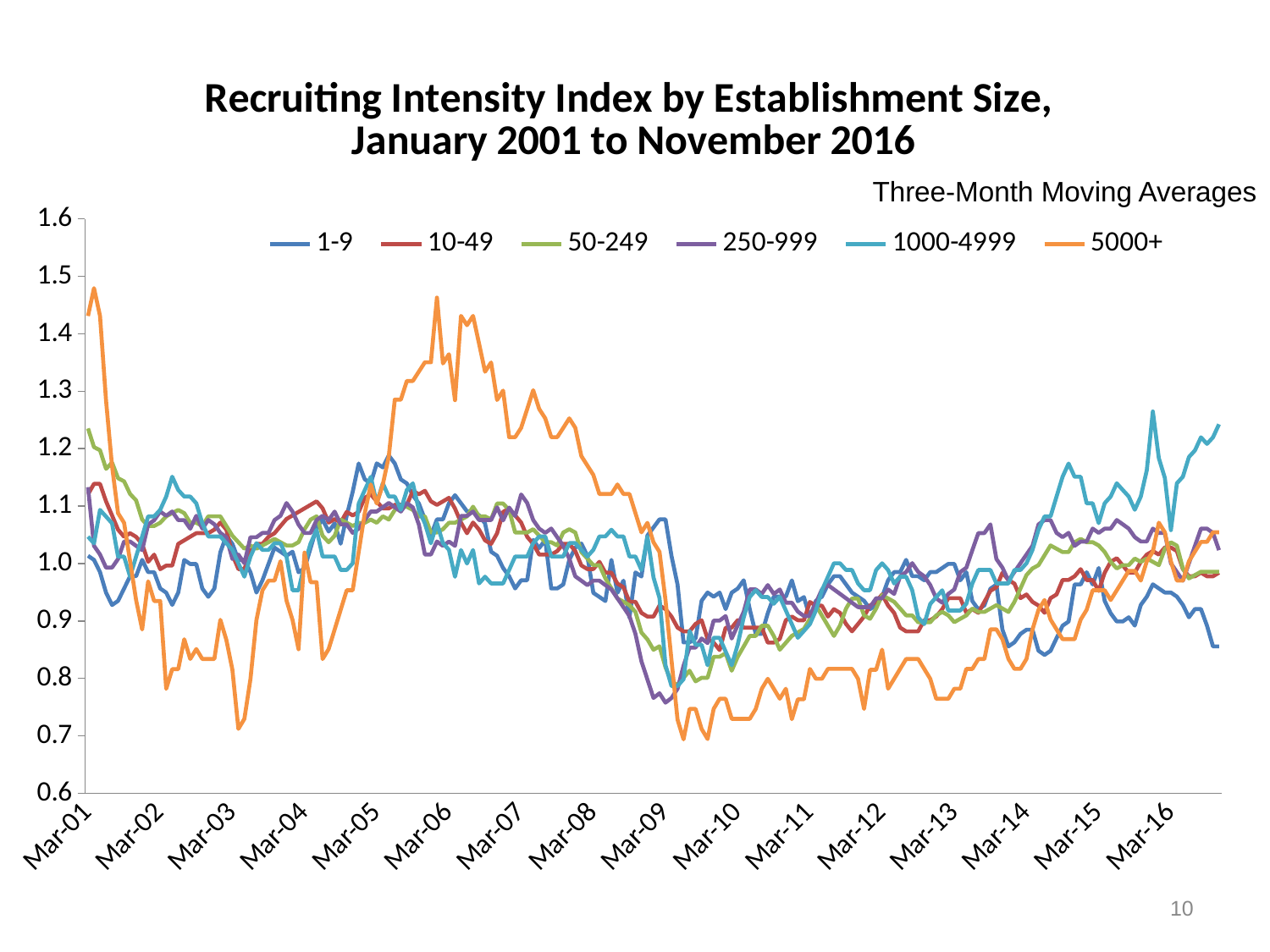
Which series has the lowest value around Mar-10? 5000+ Around Mar-03, which is larger: the 1-9 series or the 5000+ series? 1-9 Is the value for the 5000+ series around Mar-06 greater or less than 1.3? greater What does the note above the legend say the plotted values are? Three-Month Moving Averages Is the value for the 5000+ series around Mar-10 greater or less than 0.8? less How many series does the legend list? 6 What is the title of the chart? Recruiting Intensity Index by Establishment Size, January 2001 to November 2016 Which series has the lowest value at the end of the period, after Mar-16? 1-9 Which series has the highest value at the end of the period, after Mar-16? 1000-4999 What kind of chart is shown on the slide? line chart Does the 5000+ series rise or fall between Mar-06 and Mar-09? fall Which series has the highest value around Mar-06? 5000+